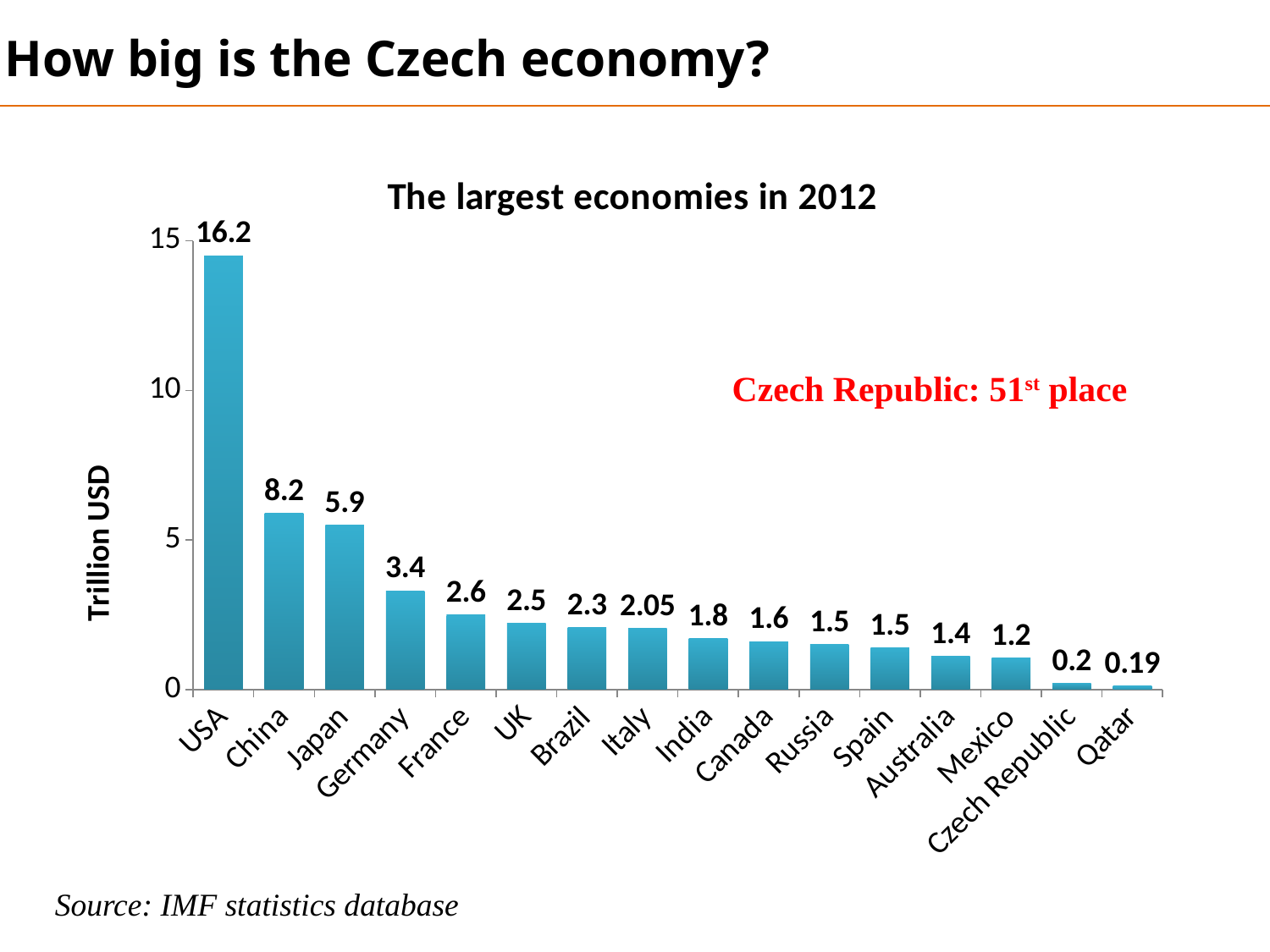
What is the title of the chart? The largest economies in 2012 What is the value for USA in the chart? 16.2 Which has a larger value, France or Brazil? France What is the value for Germany? 3.4 What is the difference between the values for China and Japan? 2.3 What kind of chart is shown on the slide? Bar chart Do the values rise or fall from left to right along the x axis? Fall Which country has the highest value in the chart? USA What is the value for the Czech Republic? 0.2 What is the value for Italy? 2.05 How many countries are shown in the chart? 16 Which country has the lowest value in the chart? Qatar